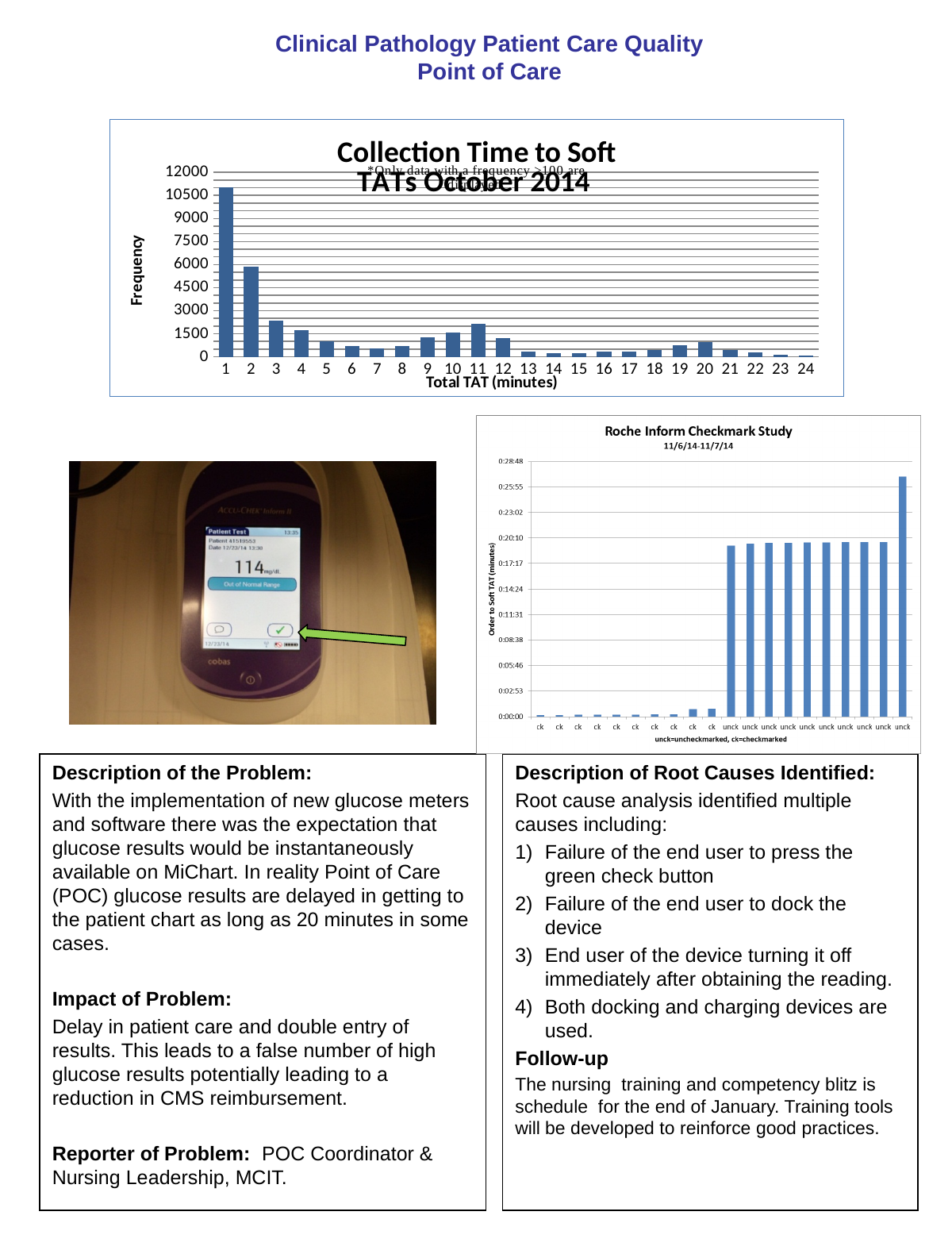
In the 'Collection Time to Soft TATs October 2014' chart, is the frequency for category 1 greater or less than 9000? greater In the 'Roche Inform Checkmark Study' chart, which group of bars has the higher Order to Soft TAT values, ck or unck? unck In the 'Collection Time to Soft TATs October 2014' chart, which Total TAT category has the highest frequency? 1 In the 'Collection Time to Soft TATs October 2014' chart, how many categories are shown on the x axis? 24 In the 'Roche Inform Checkmark Study' chart, what date range is shown under the title? 11/6/14-11/7/14 In the 'Collection Time to Soft TATs October 2014' chart, what is the label of the y axis? Frequency In the 'Roche Inform Checkmark Study' chart, is the value of the last (rightmost) unck bar greater or less than 0:25:55? greater In the 'Collection Time to Soft TATs October 2014' chart, is the frequency for category 2 greater or less than 4500? greater What kind of chart is the 'Roche Inform Checkmark Study' chart? bar chart In the 'Collection Time to Soft TATs October 2014' chart, which has the higher frequency, category 3 or category 4? 3 What kind of chart is the 'Collection Time to Soft TATs October 2014' chart? bar chart